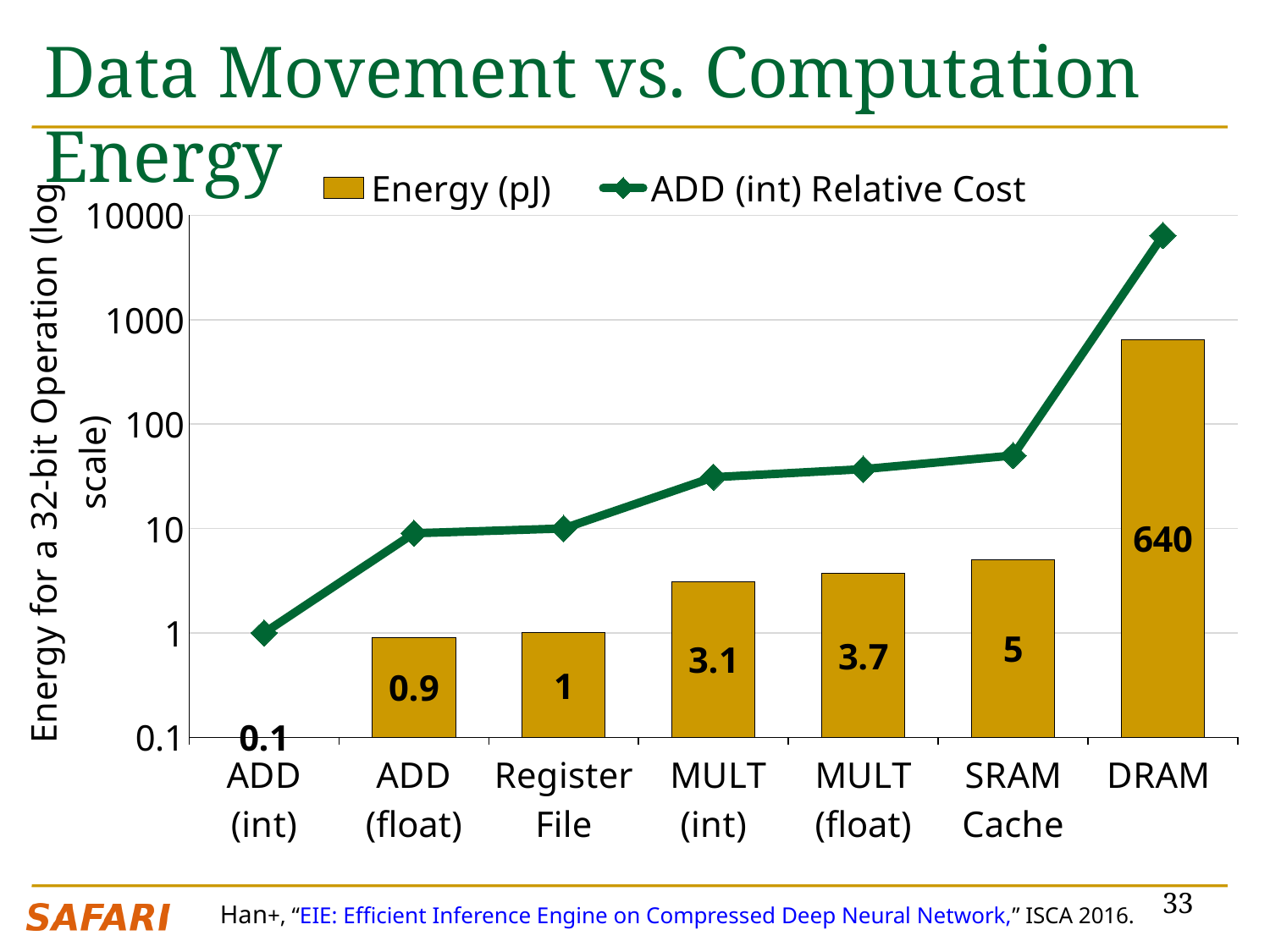
What is the Energy (pJ) value for DRAM? 640 What is the Energy (pJ) value for SRAM Cache? 5 What is the Energy (pJ) value for MULT (float)? 3.7 How many series does the legend list? 2 Which has a higher Energy (pJ) value, MULT (int) or ADD (float)? MULT (int) Which category has the lowest Energy (pJ)? ADD (int) Does the ADD (int) Relative Cost line rise or fall from ADD (int) to DRAM? rise How many categories are shown on the x axis? 7 Is the ADD (int) Relative Cost value for DRAM greater or less than 1000? greater What is the difference in Energy (pJ) between DRAM and SRAM Cache? 635 What is the Energy (pJ) value for ADD (int)? 0.1 Which category has the highest Energy (pJ)? DRAM